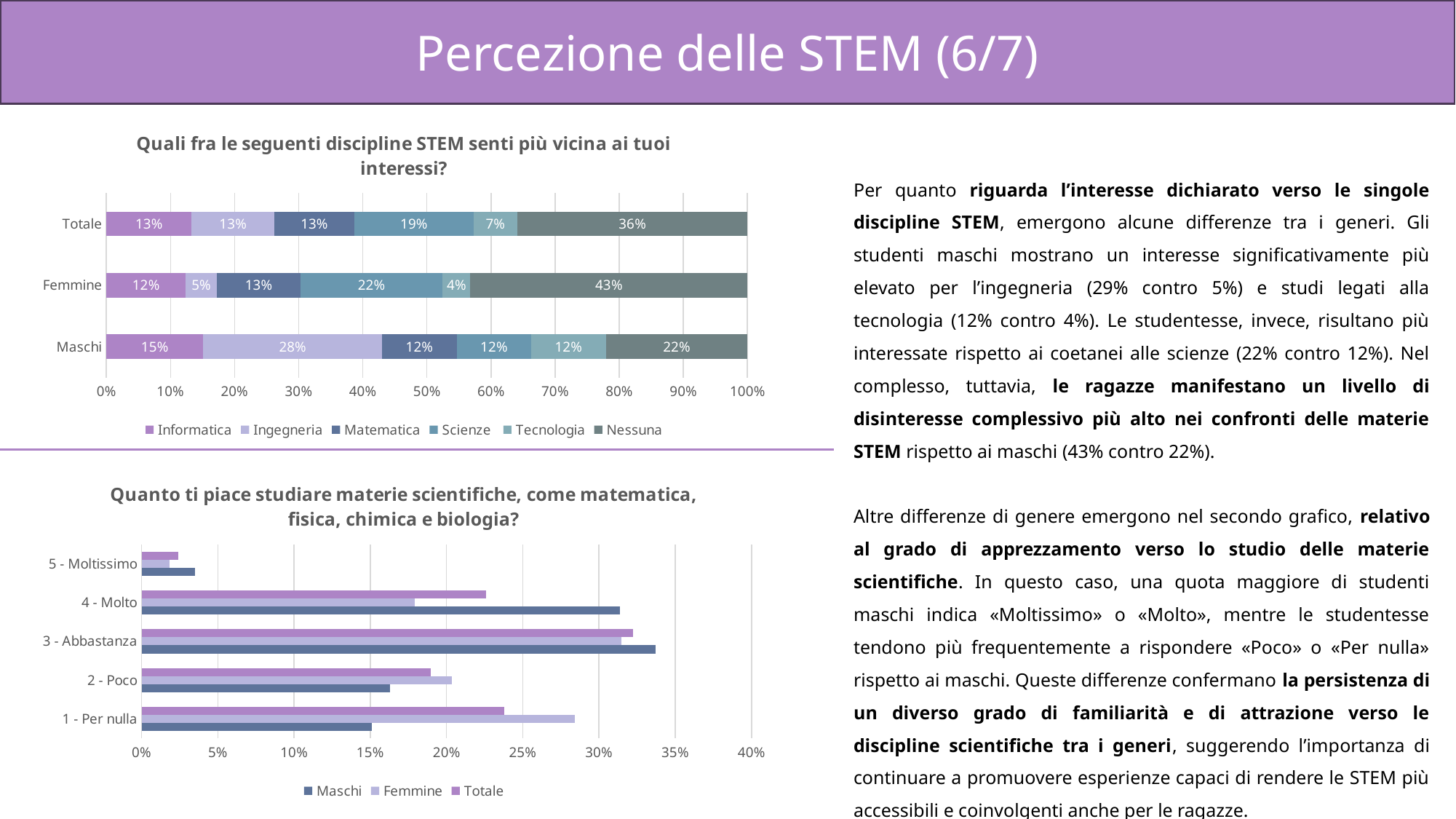
In the top chart 'Quali fra le seguenti discipline STEM senti più vicina ai tuoi interessi?', which group has the higher value for Scienze, Maschi or Femmine? Femmine What kind of chart is the bottom chart 'Quanto ti piace studiare materie scientifiche, come matematica, fisica, chimica e biologia?'? Bar chart In the top chart 'Quali fra le seguenti discipline STEM senti più vicina ai tuoi interessi?', what is the difference between the Ingegneria values for Maschi and Femmine? 23% In the bottom chart 'Quanto ti piace studiare materie scientifiche, come matematica, fisica, chimica e biologia?', which category has the lowest Maschi value? 5 - Moltissimo In the bottom chart 'Quanto ti piace studiare materie scientifiche, come matematica, fisica, chimica e biologia?', is the Maschi value for '4 - Molto' greater or less than 30%? greater In the top chart 'Quali fra le seguenti discipline STEM senti più vicina ai tuoi interessi?', what is the value for Ingegneria among Maschi? 28% In the bottom chart 'Quanto ti piace studiare materie scientifiche, come matematica, fisica, chimica e biologia?', is the Femmine value for '1 - Per nulla' greater or less than 25%? greater In the top chart 'Quali fra le seguenti discipline STEM senti più vicina ai tuoi interessi?', which discipline has the smallest share among Femmine? Tecnologia In the top chart 'Quali fra le seguenti discipline STEM senti più vicina ai tuoi interessi?', what is the value for Scienze in the Totale bar? 19% In the top chart 'Quali fra le seguenti discipline STEM senti più vicina ai tuoi interessi?', which discipline has the largest share among Femmine? Nessuna How many series does the legend of the top chart 'Quali fra le seguenti discipline STEM senti più vicina ai tuoi interessi?' list? 6 In the top chart 'Quali fra le seguenti discipline STEM senti più vicina ai tuoi interessi?', what is the value for Nessuna among Femmine? 43%